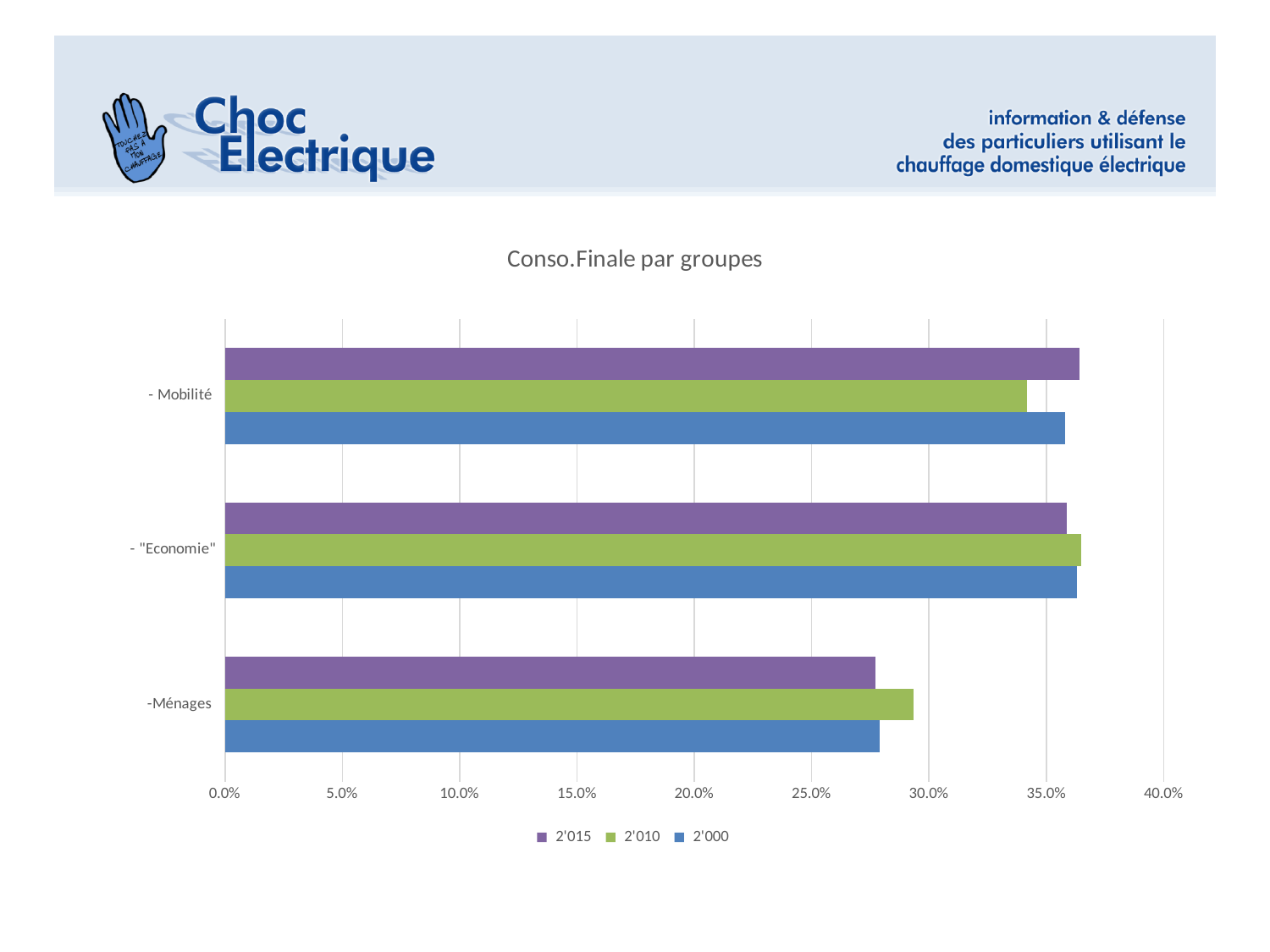
Is the value for - Mobilité in the 2'015 series greater or less than 35.0%? greater What kind of chart is shown on the slide? bar chart Is the value for -Ménages in the 2'015 series greater or less than 30.0%? less Is the value for - "Economie" in the 2'000 series greater or less than 35.0%? greater For - Mobilité, which series has the larger value, 2'010 or 2'000? 2'000 How many series does the legend list? 3 Which category has the lowest value for the 2'015 series? -Ménages How many categories are shown on the vertical axis? 3 What is the title of the chart? Conso.Finale par groupes For -Ménages, which series has the larger value, 2'010 or 2'015? 2'010 Which category has the highest value for the 2'010 series? - "Economie"